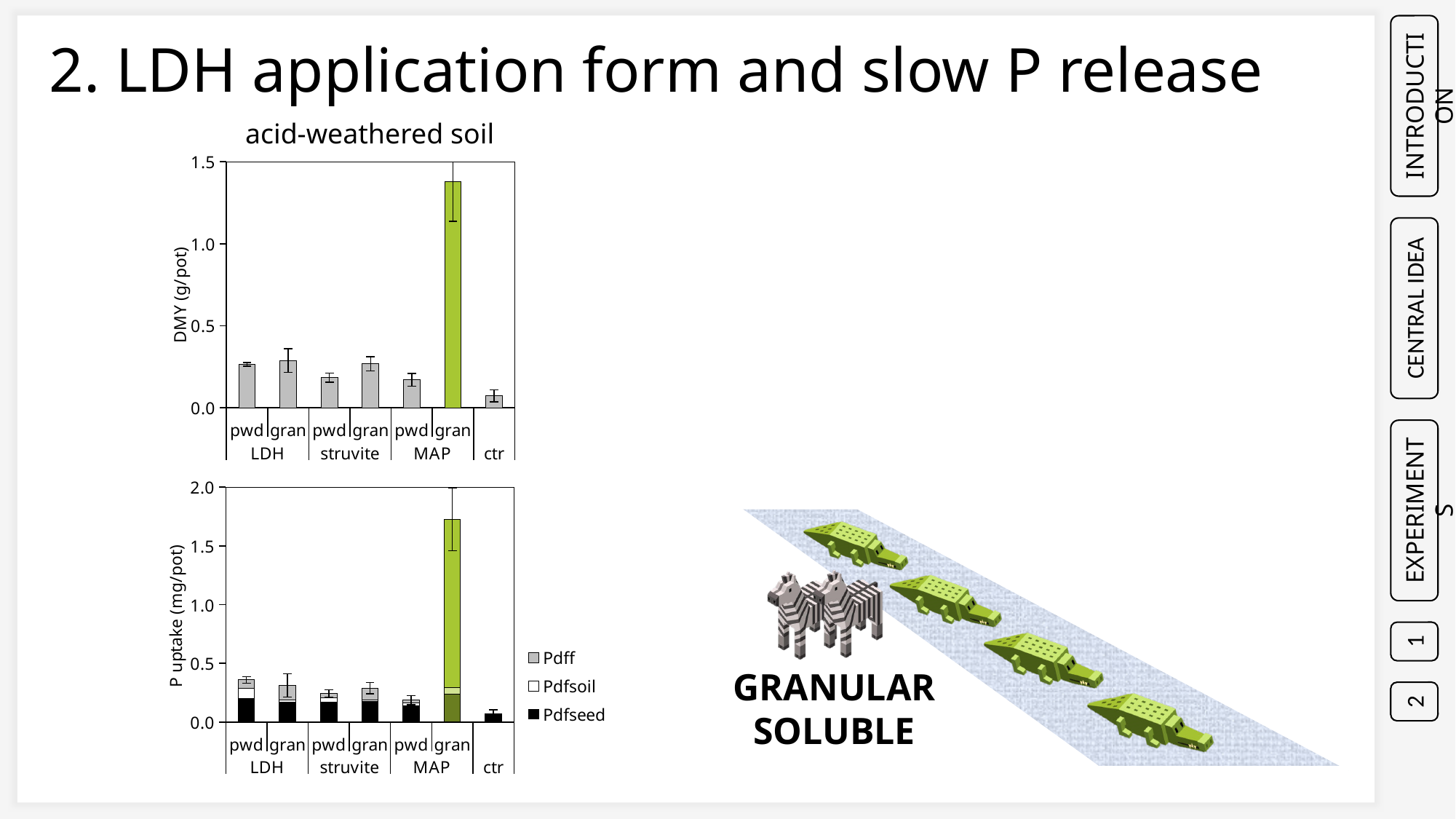
What is the y-axis label of the bottom chart? P uptake (mg/pot) In the bottom chart (P uptake), which bar has the highest total? MAP gran In the top chart (DMY), which is larger, MAP gran or LDH pwd? MAP gran What type of chart is the top chart titled 'acid-weathered soil'? bar chart In the top chart (DMY), is the value for MAP gran greater or less than 1.0? greater In the top chart (DMY), which bar is the highest? MAP gran In the bottom chart (P uptake), is the total for MAP gran greater or less than 1.5? greater In the top chart (DMY), is the value for ctr greater or less than 0.5? less In the top chart (DMY), which bar is the lowest? ctr How many series does the legend of the bottom chart (P uptake) list? 3 How many bars are plotted in the top chart (DMY)? 7